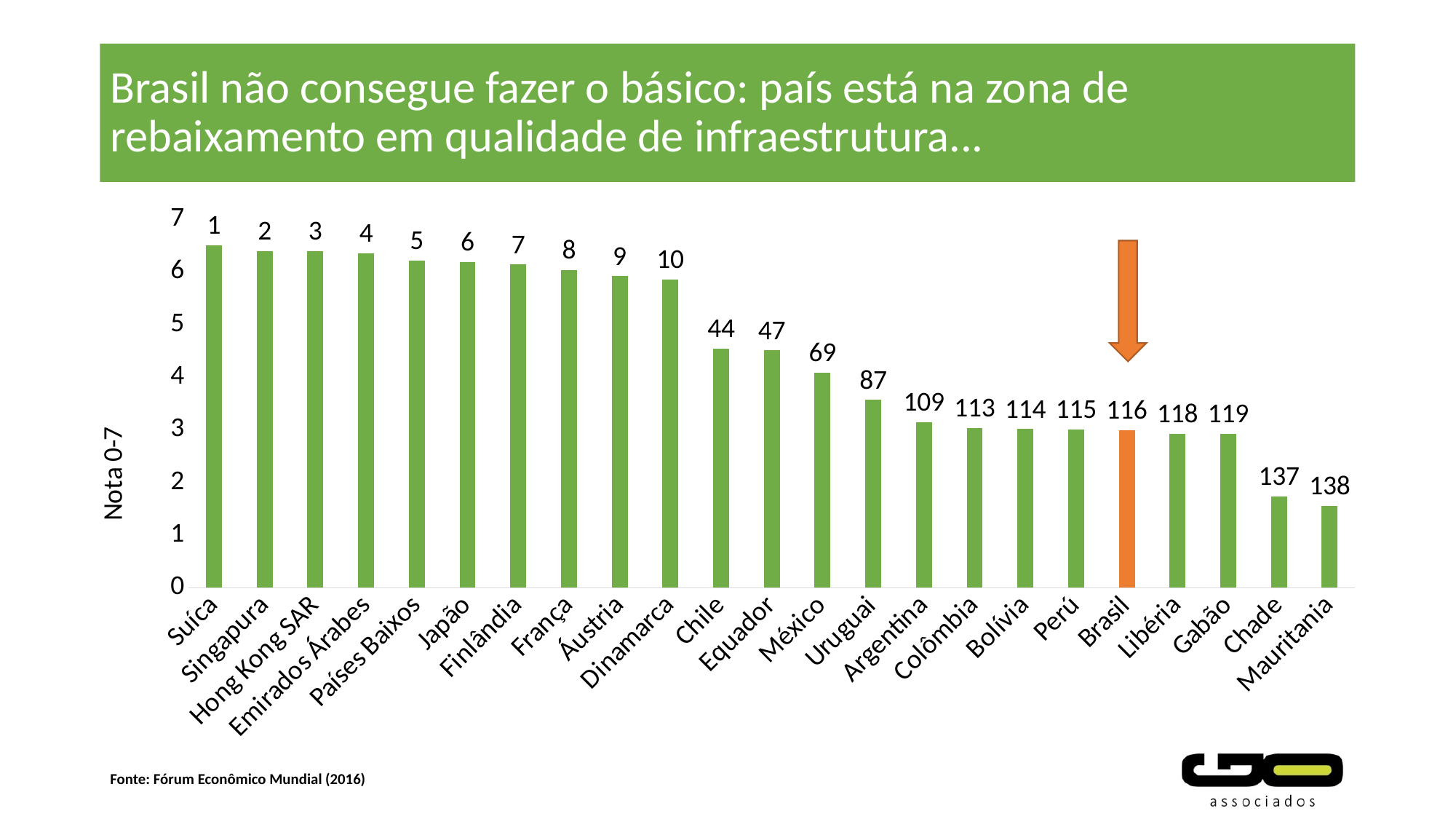
Is the value for Brasil greater or less than 4? less What rank label is printed above the bar for Brasil? 116 What rank label is printed above the bar for Chade? 137 Is the value for Suíça greater or less than 6? greater How many countries are shown in the chart? 23 Which country has the shortest bar in the chart? Mauritania Which country's bar is highlighted in orange? Brasil Is the value for Chade greater or less than 2? less What kind of chart is shown on the slide? bar chart Which country has the tallest bar in the chart? Suíça Which bar is taller, Chile or México? Chile What rank label is printed above the bar for Chile? 44